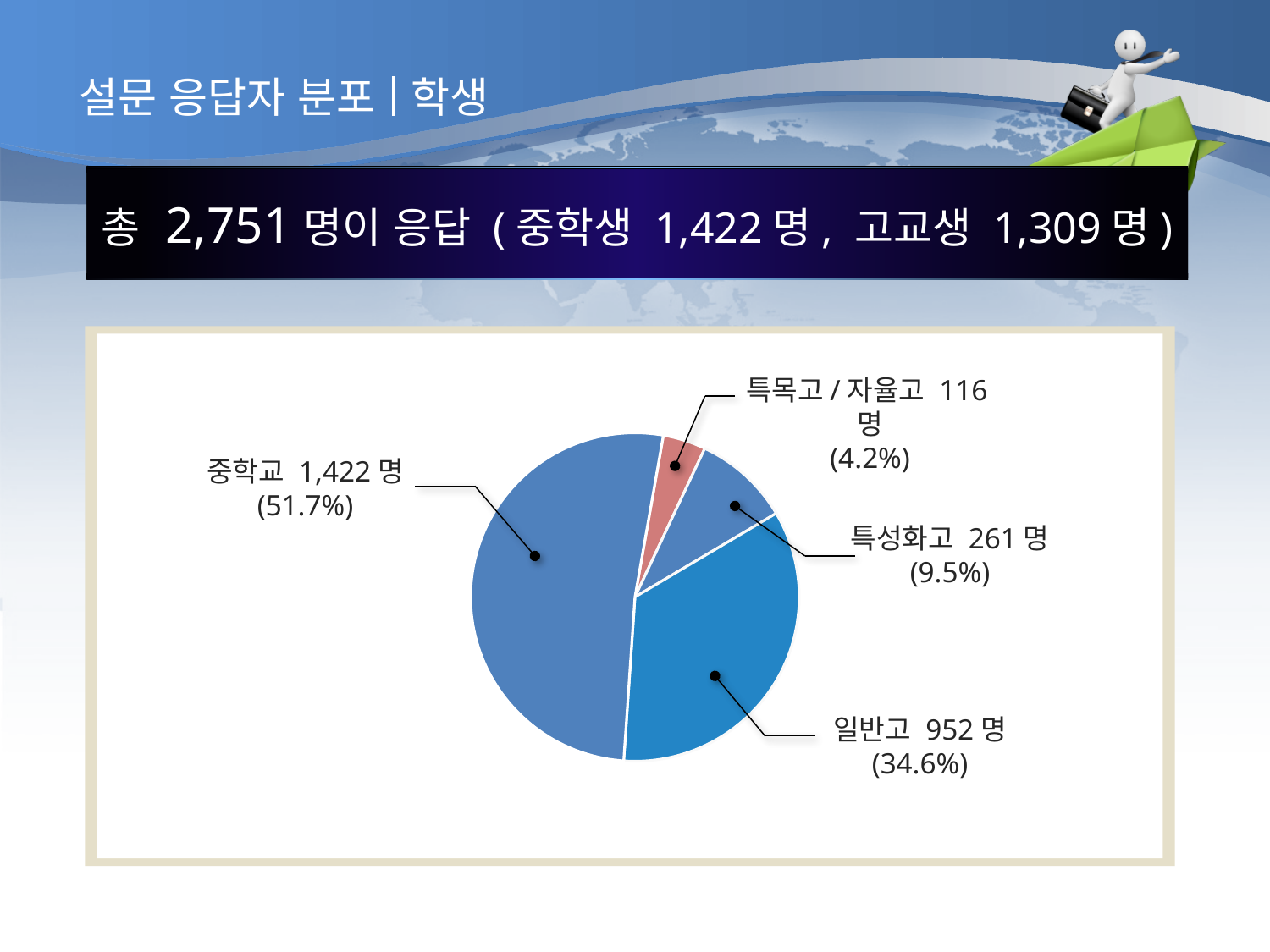
What is the difference in respondents between 중학교 and 일반고? 470 명 How many respondents are in the 특목고/자율고 slice? 116 명 How many respondents are in the 중학교 slice? 1,422 명 What share of the pie does the 특성화고 slice represent? 9.5% Which category has the smallest slice of the pie? 특목고/자율고 How many respondents are in the 일반고 slice? 952 명 Which has more respondents, 특성화고 or 특목고/자율고? 특성화고 What share of the pie does the 일반고 slice represent? 34.6% What kind of chart is shown on the slide? pie chart How many respondents are in the 특성화고 slice? 261 명 Which category has the largest slice of the pie? 중학교 How many slices does the pie chart have? 4